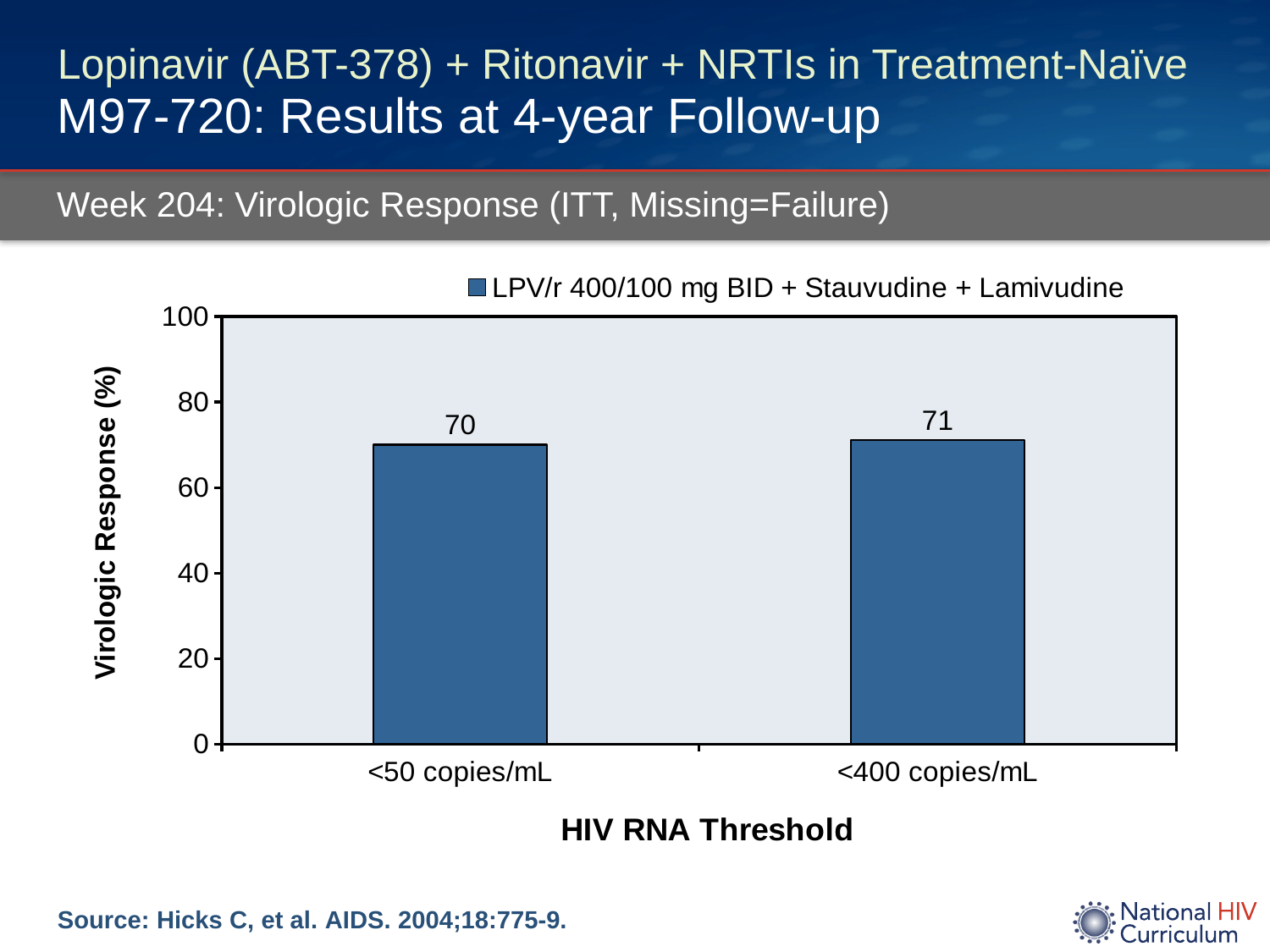
What is the virologic response (%) for the <50 copies/mL threshold? 70 What is the label of the y axis? Virologic Response (%) How many series does the legend list? 1 How many HIV RNA threshold categories are shown on the x axis? 2 Is the virologic response for <50 copies/mL greater or less than 80? less What series name is listed in the legend? LPV/r 400/100 mg BID + Stauvudine + Lamivudine Which HIV RNA threshold has the higher virologic response? <400 copies/mL What is the virologic response (%) for the <400 copies/mL threshold? 71 Is the virologic response for <400 copies/mL greater or less than 60? greater What kind of chart is shown on the slide? bar chart Which HIV RNA threshold has the lower virologic response? <50 copies/mL What is the difference in virologic response between the <400 copies/mL and <50 copies/mL thresholds? 1